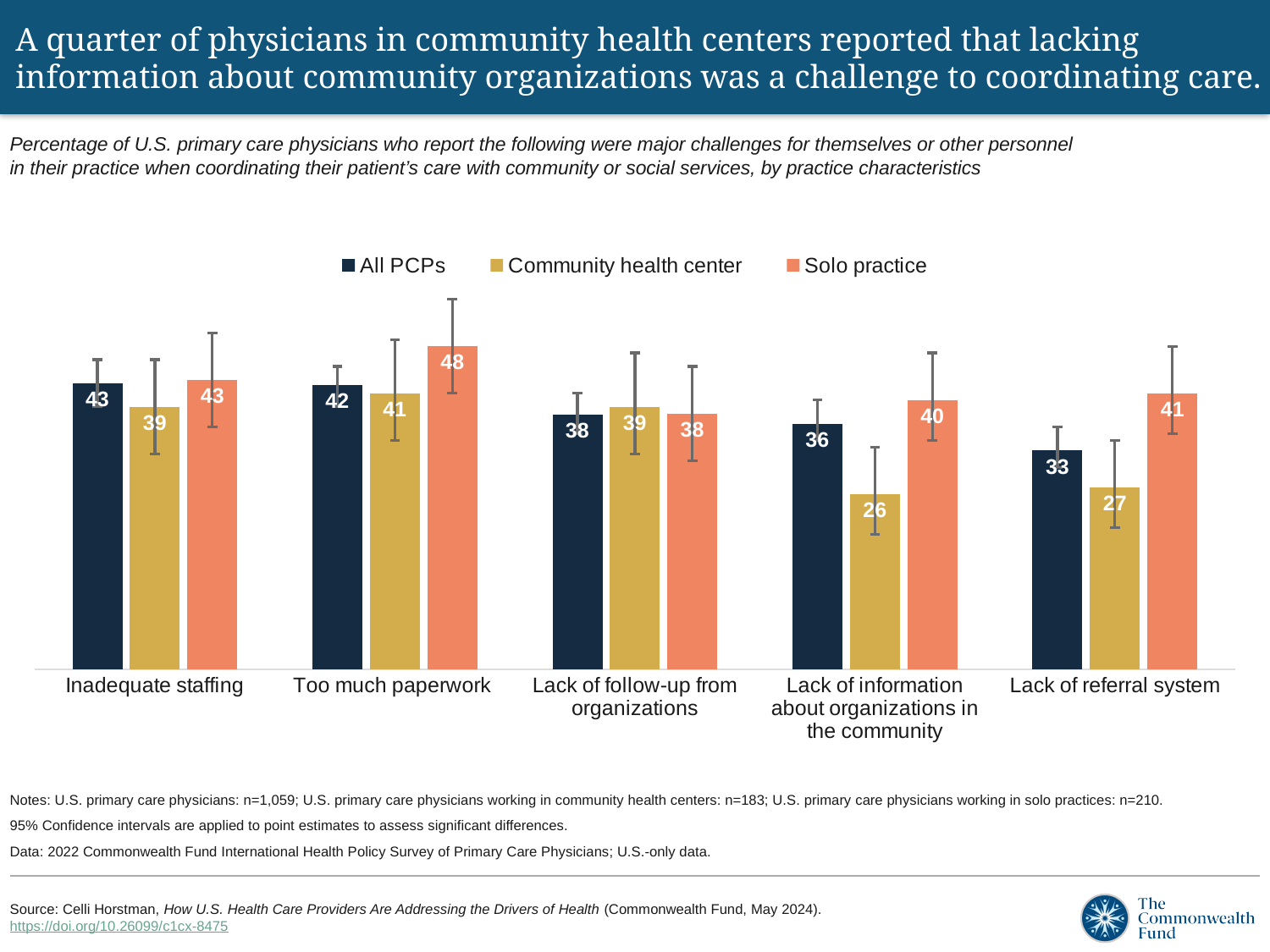
Which category has the highest value for Solo practice? Too much paperwork What is the value for Solo practice under 'Too much paperwork'? 48 How many series does the legend list? 3 Which series is shown in orange? Solo practice What is the value for All PCPs under 'Lack of referral system'? 33 Under 'Lack of information about organizations in the community', which is larger: the All PCPs value or the Solo practice value? Solo practice Which category has the lowest value for Community health center? Lack of information about organizations in the community What is the value for Community health center under 'Lack of information about organizations in the community'? 26 Do the All PCPs values rise or fall from 'Inadequate staffing' to 'Lack of referral system'? Fall How many categories are shown on the x axis? 5 What is the difference between the Solo practice and Community health center values under 'Lack of referral system'? 14 What kind of chart is this? Bar chart